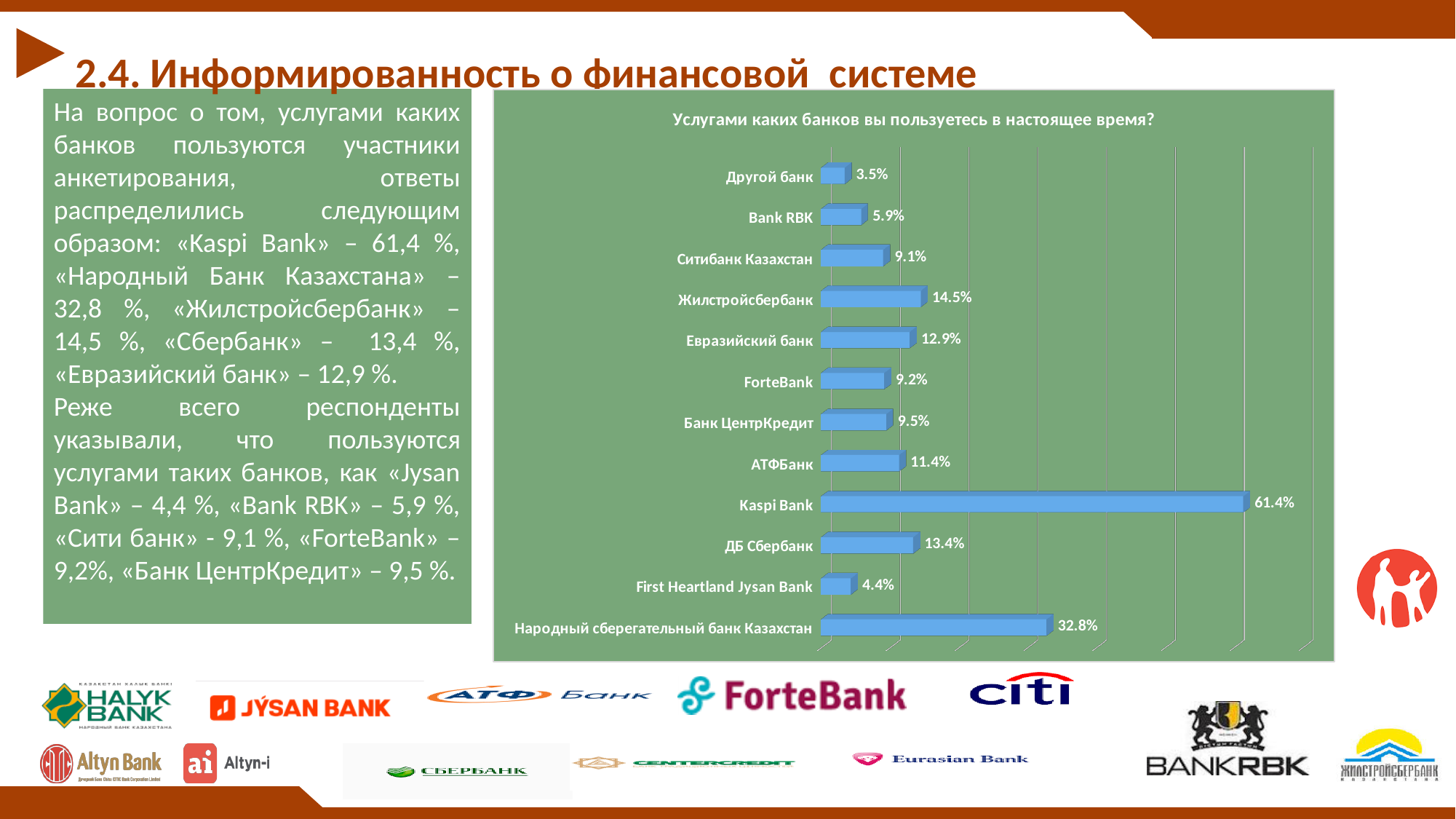
Which is larger, the value for АТФБанк or the value for Банк ЦентрКредит? АТФБанк Which bank has the highest value in the chart? Kaspi Bank What value is shown for Народный сберегательный банк Казахстан? 32.8% What value is shown for First Heartland Jysan Bank? 4.4% What is the title of the chart? Услугами каких банков вы пользуетесь в настоящее время? Which category has the lowest value in the chart? Другой банк What is the difference between the values for Kaspi Bank and Народный сберегательный банк Казахстан? 28.6% What is the difference between the values for Жилстройсбербанк and Евразийский банк? 1.6% What value is shown for Жилстройсбербанк? 14.5% What value is shown for Kaspi Bank? 61.4% What type of chart is shown on the slide? Bar chart How many banks (categories) are shown in the chart? 12